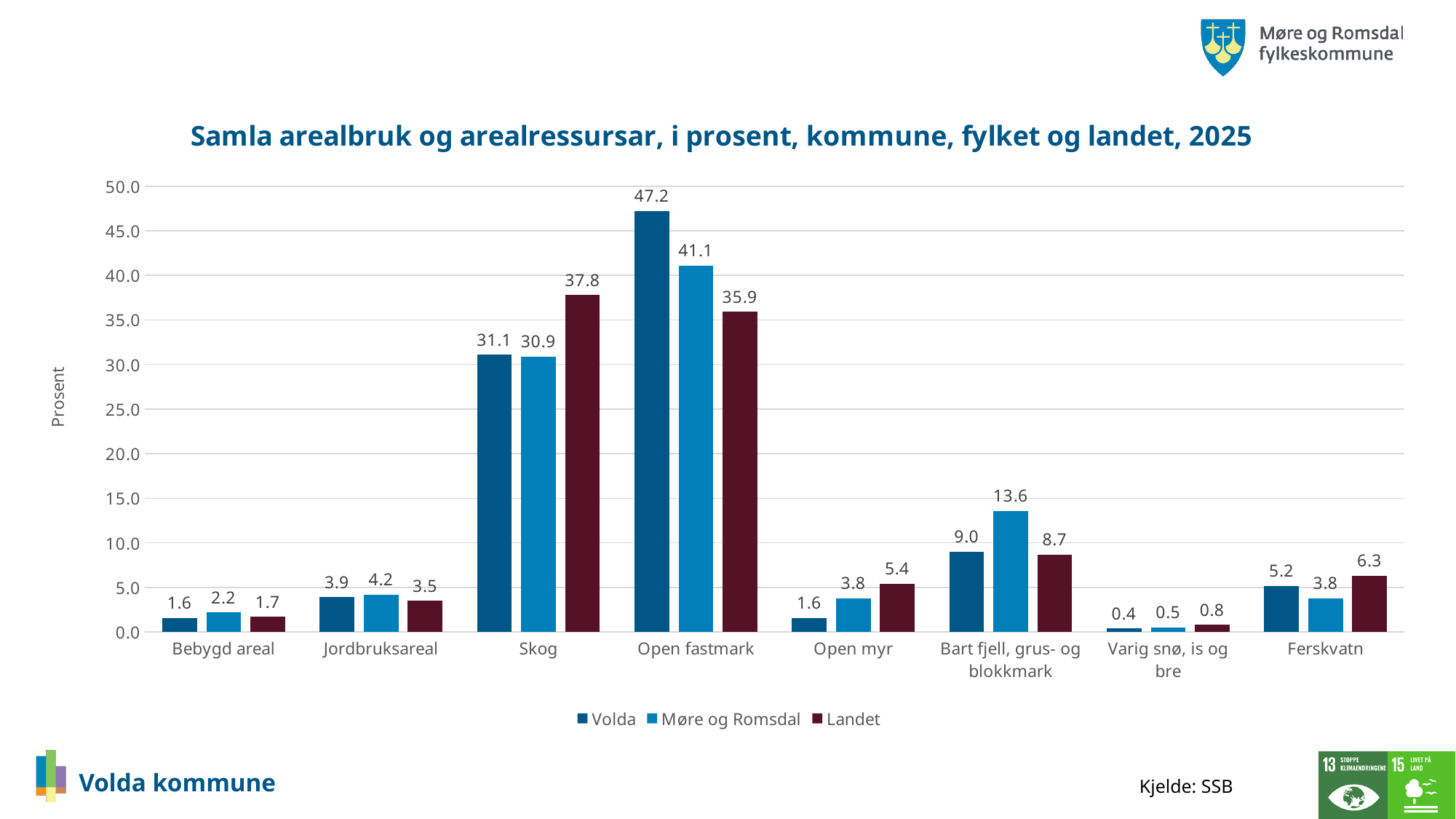
How many categories are shown on the x axis? 8 What kind of chart is shown on the slide? bar chart How many series does the legend list? 3 What is the value for Landet in the Skog category? 37.8 Which category has the lowest value for Landet? Varig snø, is og bre Which category has the highest value for Volda? Open fastmark What is the value for Volda in the Open fastmark category? 47.2 What is the difference between the Volda and Landet values for Open fastmark? 11.3 What is the value for Møre og Romsdal in the Bart fjell, grus- og blokkmark category? 13.6 Is the value for Møre og Romsdal in the Skog category greater or less than 35.0? less Which is larger in the Ferskvatn category: Volda or Landet? Landet What is the title of the chart? Samla arealbruk og arealressursar, i prosent, kommune, fylket og landet, 2025